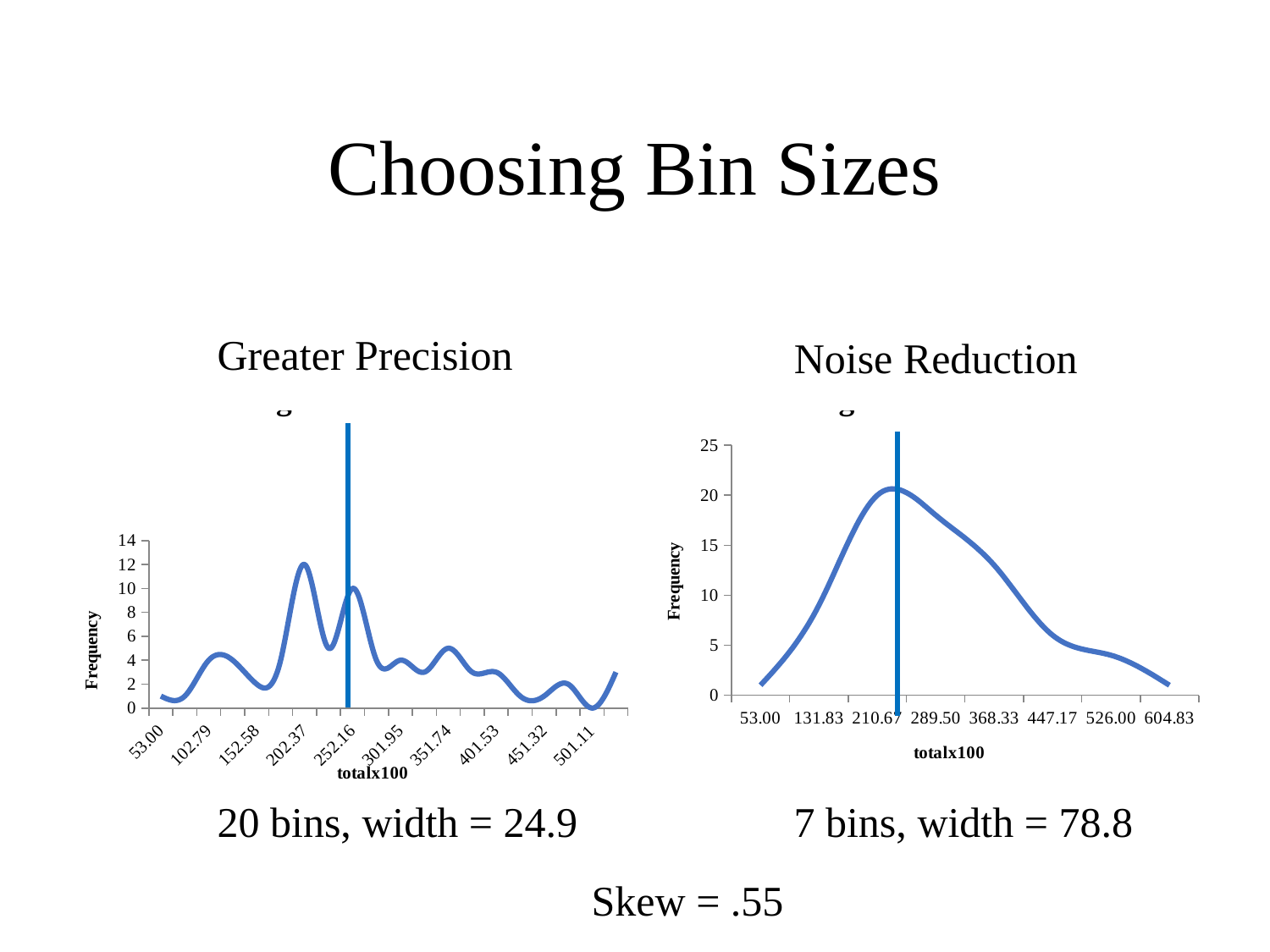
In the right chart under "Noise Reduction", do the frequencies rise or fall from 289.50 to 604.83? fall How many labelled tick values are shown on the horizontal axis of the right chart under "Noise Reduction"? 8 In the right chart under "Noise Reduction", is the frequency at 368.33 greater or less than 10? greater What is the label on the horizontal axis of the left chart under "Greater Precision"? totalx100 In the left chart under "Greater Precision", at which labelled x-axis value does the line reach its highest frequency? 202.37 What is the label on the vertical axis of the right chart under "Noise Reduction"? Frequency In the left chart under "Greater Precision", is the frequency at 53.00 greater or less than 2? less In the left chart under "Greater Precision", is the frequency at 202.37 larger or smaller than the frequency at 102.79? larger In the right chart under "Noise Reduction", is the frequency at 604.83 greater or less than 5? less What kind of chart is the left chart under "Greater Precision"? line chart